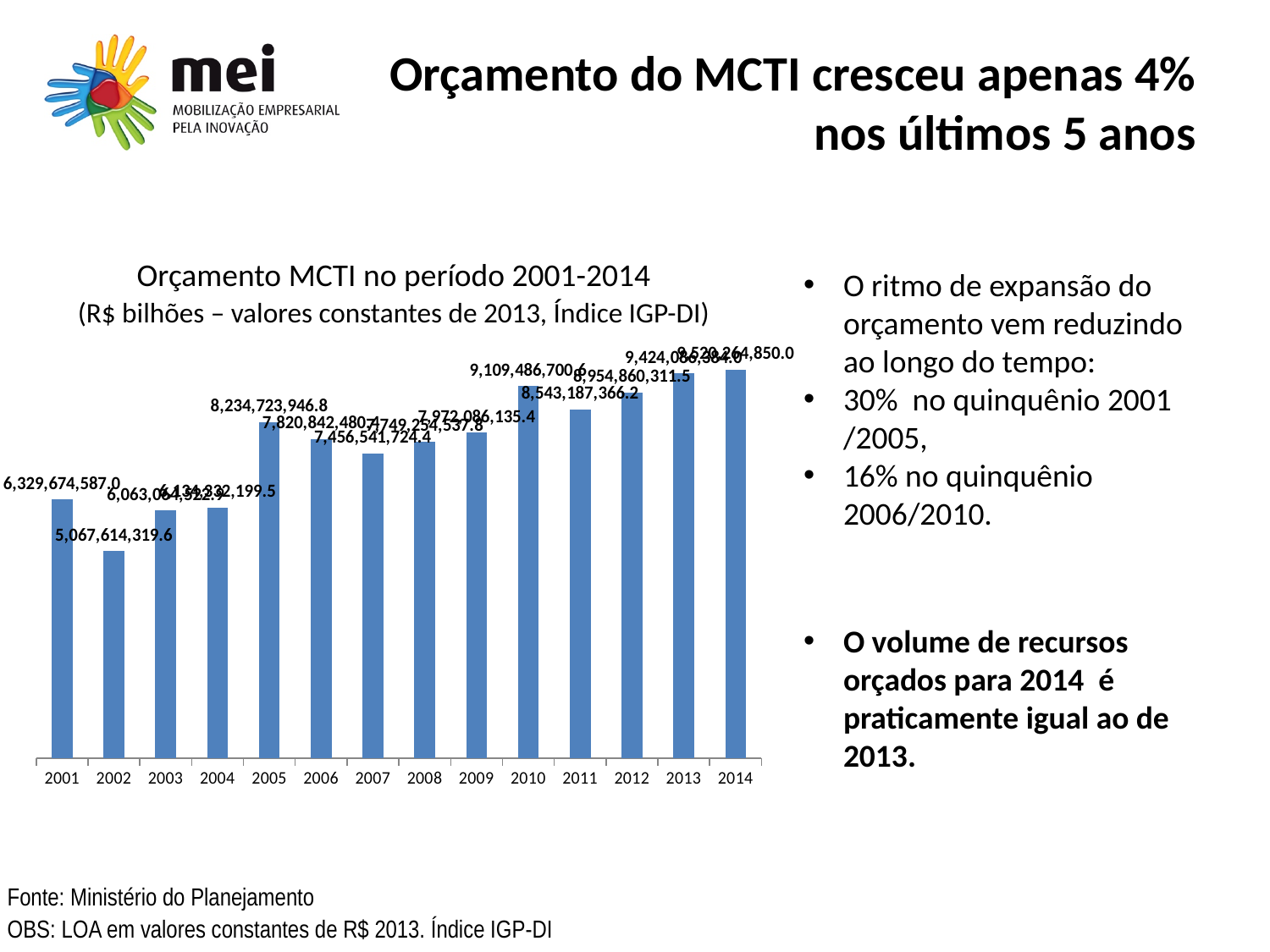
How many years are plotted on the x axis of the chart? 14 Do the values generally rise or fall from 2001 to 2014? Rise Which is larger, the value for 2010 or the value for 2011? 2010 What is the value for 2005? 8,234,723,946.8 Which is larger, the value for 2004 or the value for 2005? 2005 What is the value for 2007? 7,456,541,724.4 What is the value for 2002? 5,067,614,319.6 What is the difference between the values for 2001 and 2002? 1,262,060,267.4 Which year has the lowest value? 2002 What is the value for 2001? 6,329,674,587.0 What type of chart is shown on the slide? Bar chart What is the title of the chart? Orçamento MCTI no período 2001-2014 (R$ bilhões – valores constantes de 2013, Índice IGP-DI)